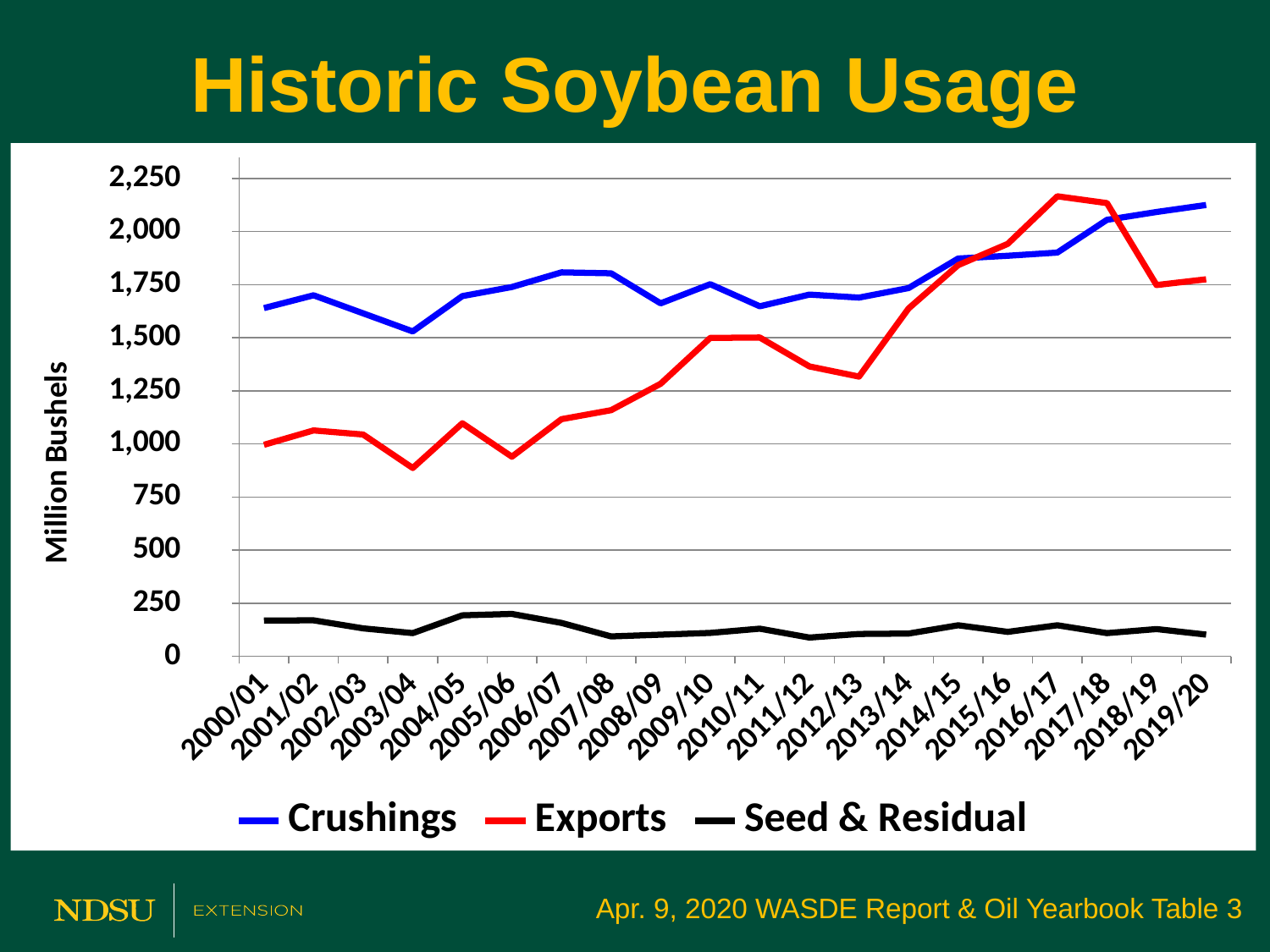
How many series does the legend list? 3 What kind of chart is shown on the slide? Line chart Do Exports rise or fall from 2012/13 to 2016/17? Rise Is the value for Seed & Residual in 2005/06 greater or less than 250? less What is the label on the vertical axis? Million Bushels Is the value for Exports in 2016/17 greater or less than 2,000? greater Is the value for Crushings in 2019/20 greater or less than 2,000? greater What is the title of the chart? Historic Soybean Usage Which series has the lowest values across all years? Seed & Residual How many marketing years are shown along the x axis? 20 Which is larger in 2000/01, Crushings or Exports? Crushings